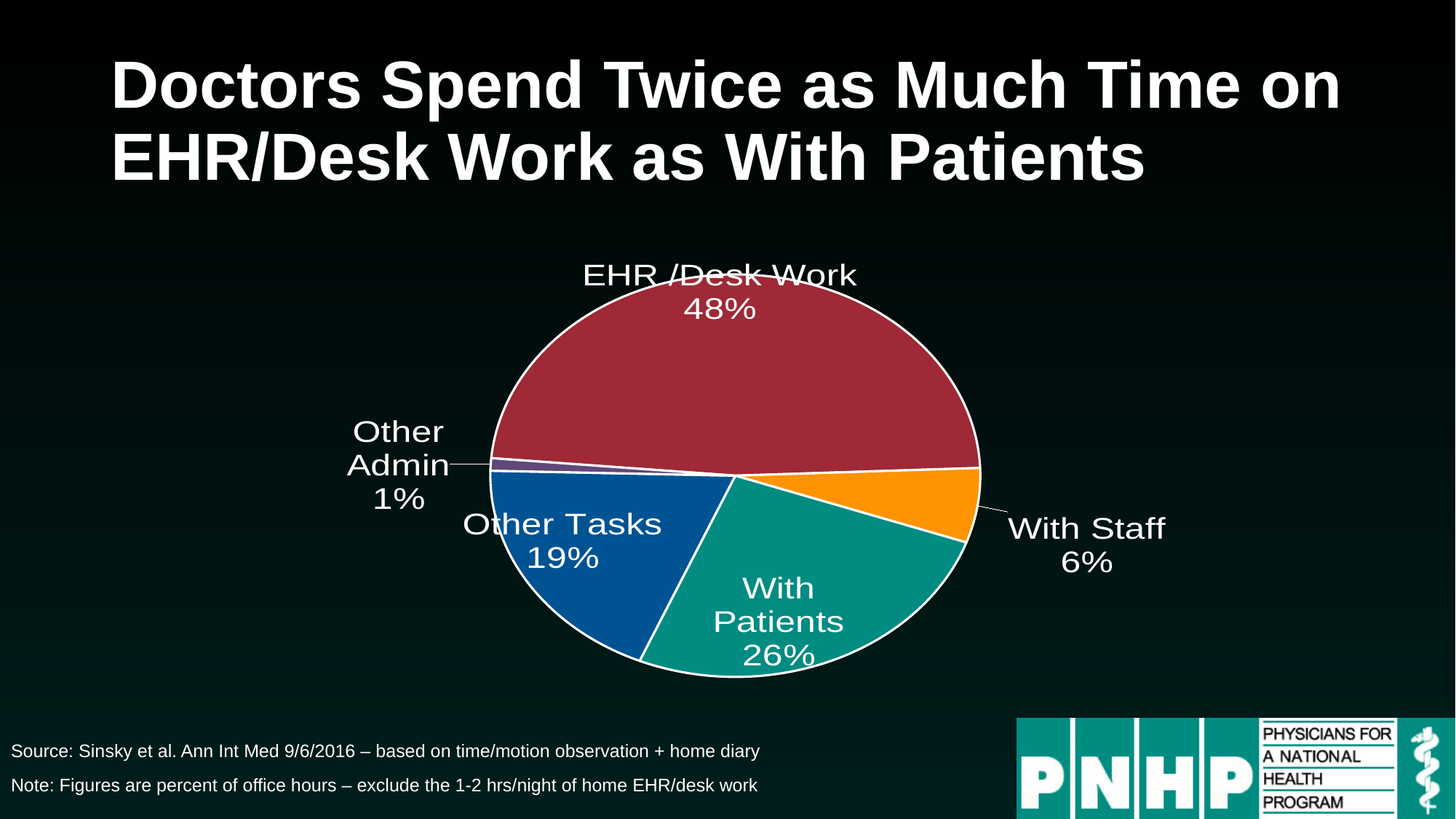
What percentage of office hours is spent With Patients? 26% What share of office hours is spent on EHR/Desk Work? 48% What colour is the With Patients slice? Teal What percentage is shown for With Staff? 6% Which category takes the largest share of the pie? EHR /Desk Work What is the value for Other Tasks? 19% What is the value for Other Admin? 1% What type of chart is shown on the slide? Pie chart How many percentage points larger is EHR/Desk Work than With Patients? 22 Which is larger, Other Tasks or With Staff? Other Tasks How many slices does the pie chart have? 5 Which category has the smallest slice? Other Admin